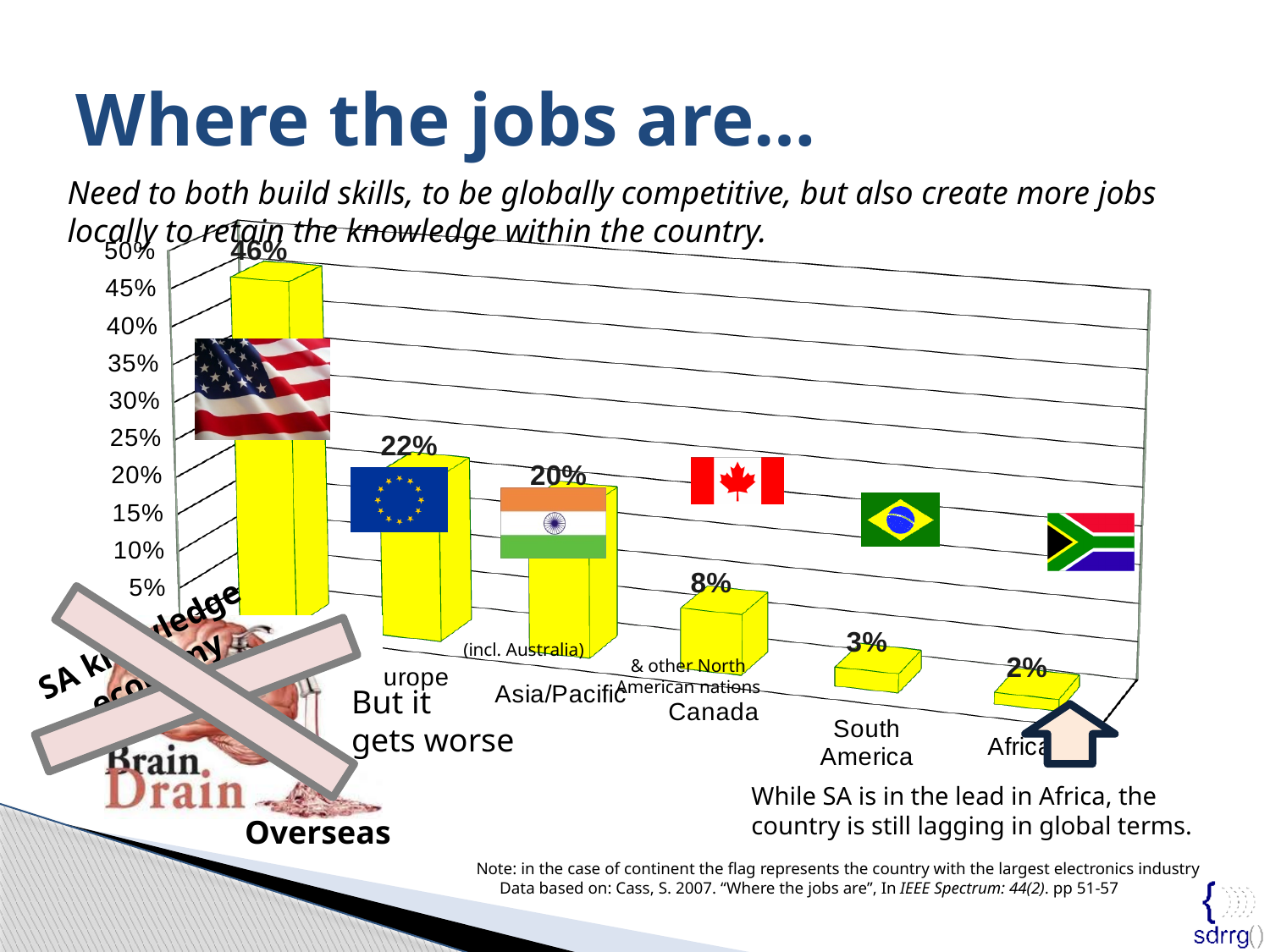
Which category has the lowest value on the chart? Africa What percentage is shown for South America? 3% What percentage is shown for Canada & other North American nations? 8% Do the values rise or fall from left to right across the chart? Fall What is the highest value shown on the chart? 46% What percentage is shown for Asia/Pacific? 20% Which is larger, the value for Canada & other North American nations or the value for South America? Canada & other North American nations What is the difference between the values for Europe and Asia/Pacific? 2% How many bars are plotted on the chart? 6 What percentage is shown for Europe? 22% What kind of chart is shown on the slide? Bar chart What percentage is shown for Africa? 2%